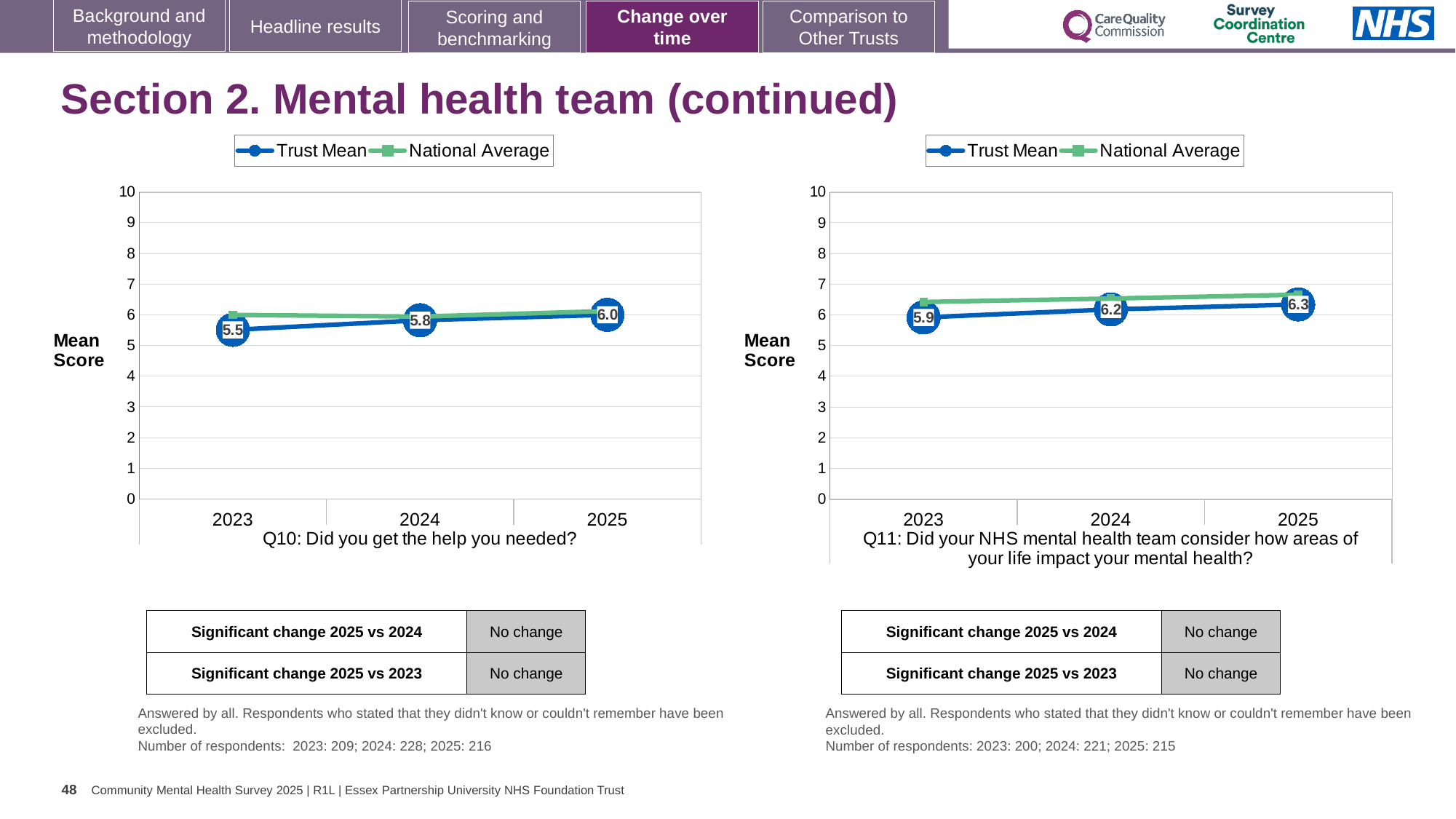
In the Q10 chart, which is higher in 2023: the Trust Mean or the National Average? National Average In the Q11 chart, what is the Trust Mean for 2025? 6.3 In the Q11 chart, what is the Trust Mean for 2024? 6.2 In the Q10 chart, what is the Trust Mean for 2023? 5.5 In the Q10 chart, does the Trust Mean rise or fall from 2023 to 2025? rise In the Q10 chart, which year has the highest Trust Mean? 2025 How many series does the legend of the Q11 chart list? 2 In the Q11 chart, what is the difference between the Trust Mean for 2024 and 2023? 0.3 In the Q10 chart, what is the Trust Mean for 2025? 6.0 In the Q11 chart, is the National Average for 2023 greater or less than 5? greater In the Q10 chart, what is the difference between the Trust Mean for 2025 and 2023? 0.5 In the Q11 chart, which year has the lowest Trust Mean? 2023